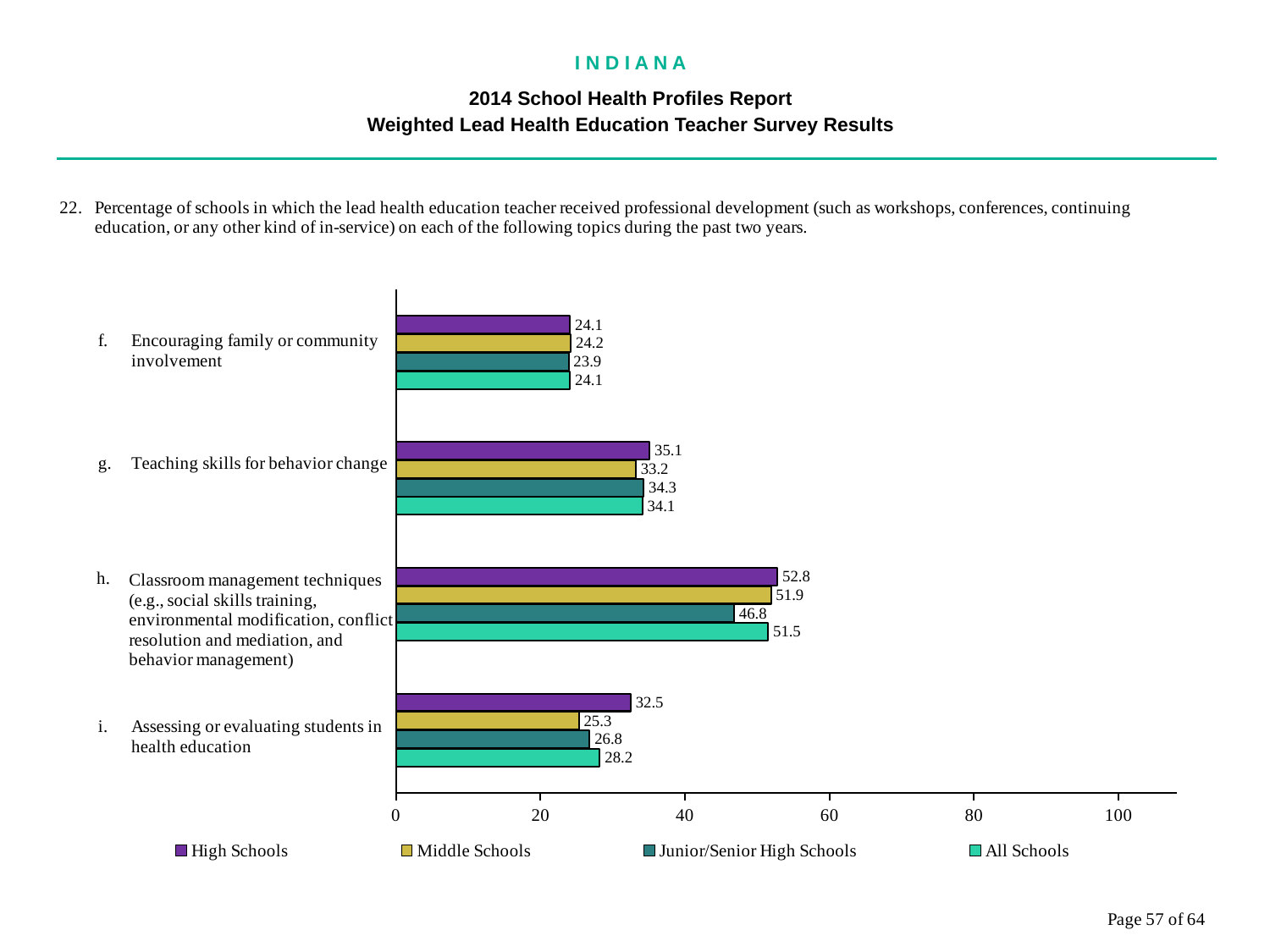
How many topics (categories) are shown in the chart? 4 For 'Classroom management techniques', which is larger: the Middle Schools value or the Junior/Senior High Schools value? Middle Schools What is the High Schools value for 'Classroom management techniques'? 52.8 Which topic has the highest All Schools value? Classroom management techniques What is the All Schools value for 'Encouraging family or community involvement'? 24.1 How many series does the legend list? 4 What is the Junior/Senior High Schools value for 'Teaching skills for behavior change'? 34.3 Which topic has the lowest High Schools value? Encouraging family or community involvement What is the difference between the High Schools and Middle Schools values for 'Assessing or evaluating students in health education'? 7.2 Is the High Schools value for 'Classroom management techniques' greater or less than 40? greater What kind of chart is shown on the slide? Bar chart What is the Middle Schools value for 'Assessing or evaluating students in health education'? 25.3